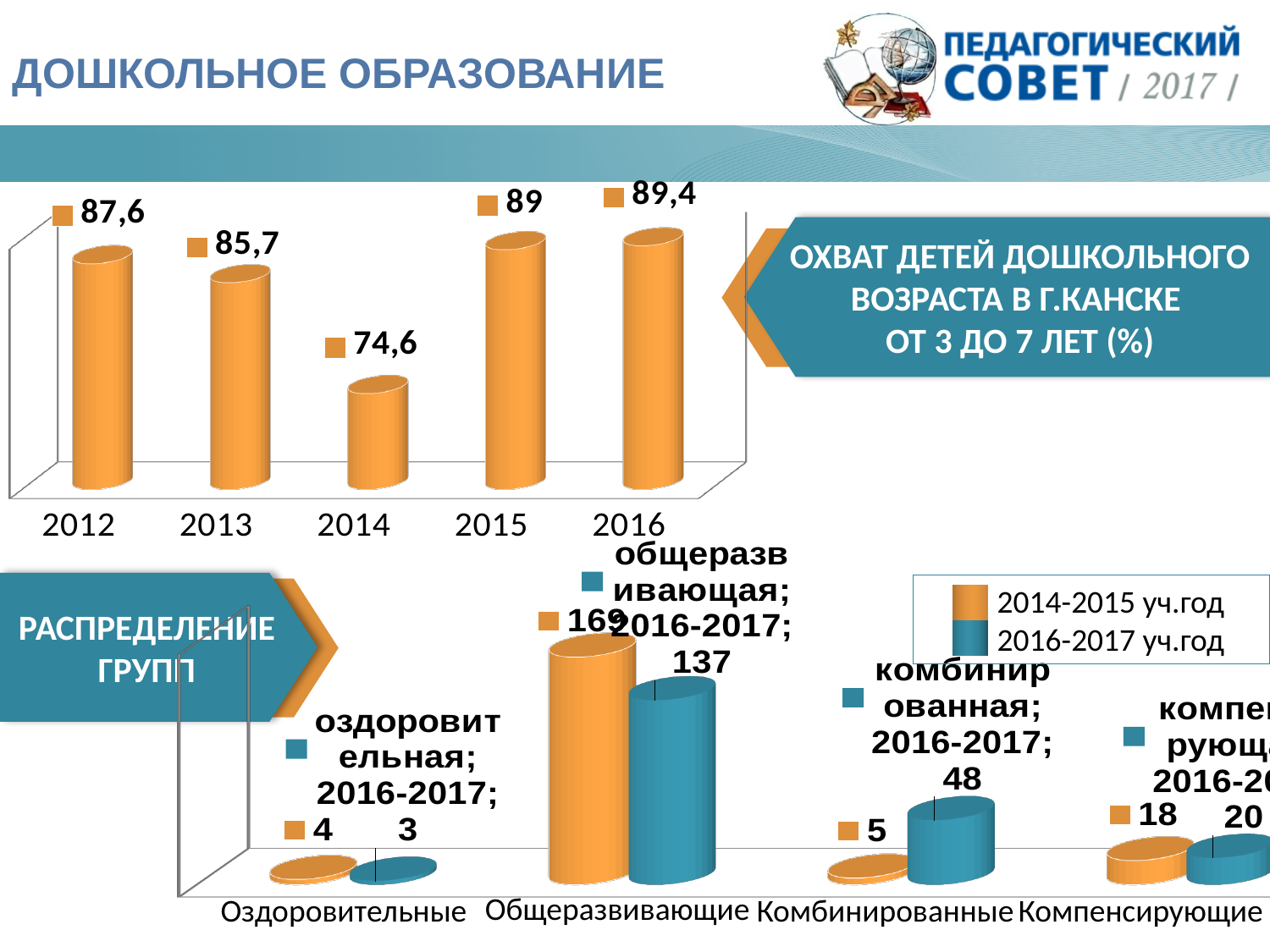
In the bottom chart (Распределение групп), how many series does the legend list? 2 In the top chart (coverage of preschool children aged 3 to 7 in Kansk), what is the difference between the values for 2012 and 2013? 1,9 In the top chart (coverage of preschool children aged 3 to 7 in Kansk), what is the value for 2014? 74,6 In the bottom chart (Распределение групп), what is the value for Общеразвивающие in 2016-2017 уч.год? 137 In the bottom chart (Распределение групп), which is larger for Комбинированные: the 2014-2015 уч.год value or the 2016-2017 уч.год value? 2016-2017 уч.год In the bottom chart (Распределение групп), what is the difference between the 2014-2015 уч.год and 2016-2017 уч.год values for Общеразвивающие? 32 In the top chart (coverage of preschool children aged 3 to 7 in Kansk), what is the value for 2016? 89,4 What kind of chart is the top chart (coverage of preschool children aged 3 to 7 in Kansk)? bar chart In the top chart (coverage of preschool children aged 3 to 7 in Kansk), which year has the highest value? 2016 In the top chart (coverage of preschool children aged 3 to 7 in Kansk), how many years are shown on the x axis? 5 In the bottom chart (Распределение групп), what is the value for Комбинированные in 2014-2015 уч.год? 5 In the top chart (coverage of preschool children aged 3 to 7 in Kansk), which year has the lowest value? 2014